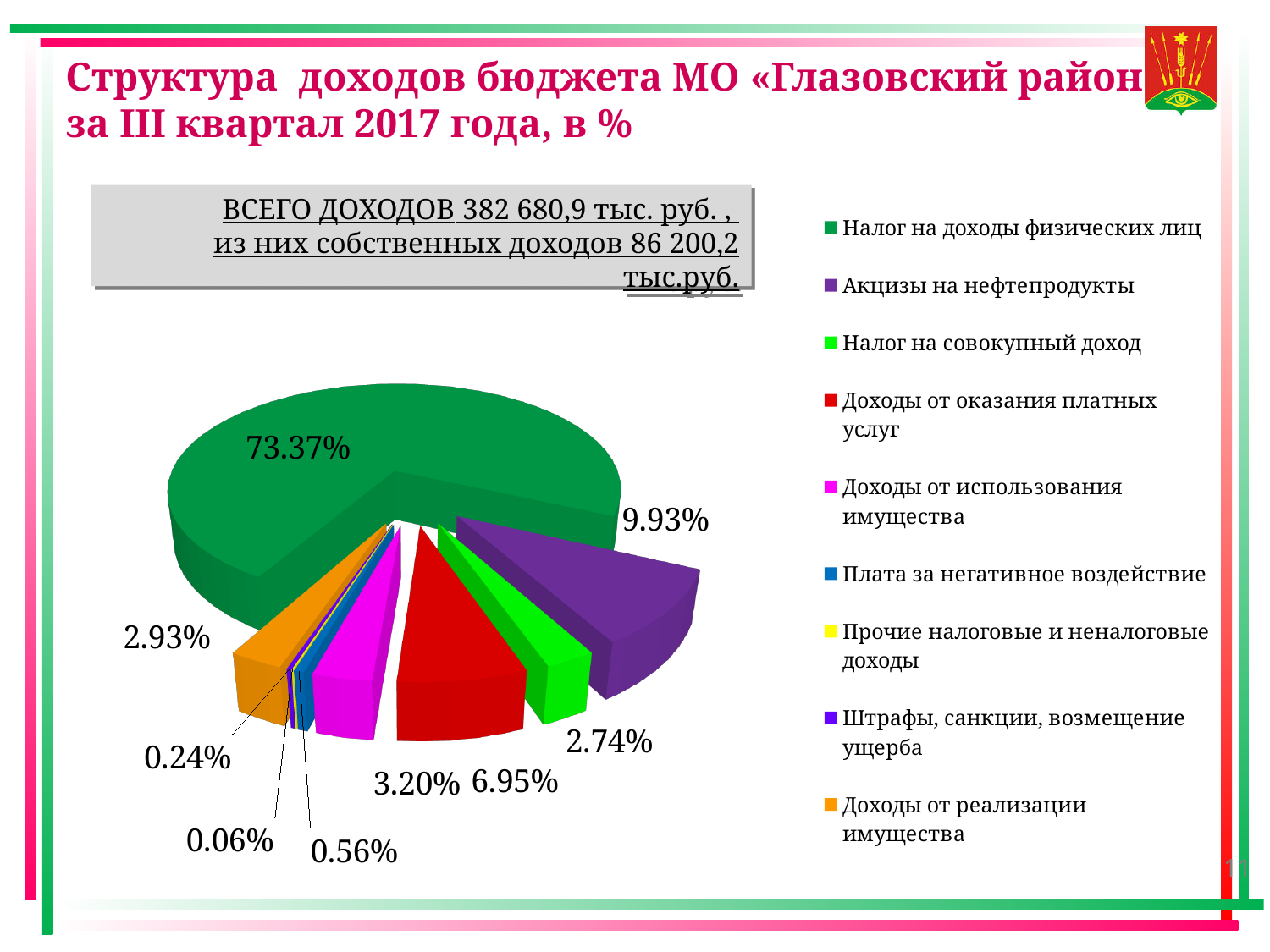
How many categories does the legend list? 9 What is the value shown for «Доходы от использования имущества»? 3.20% What is the value shown for «Доходы от реализации имущества»? 2.93% What type of chart is shown on the slide? Pie chart Which category has the largest share of the pie? Налог на доходы физических лиц What colour is the slice for «Штрафы, санкции, возмещение ущерба»? Violet (purple) What is the difference between the shares of «Акцизы на нефтепродукты» and «Доходы от оказания платных услуг»? 2.98% What share of the pie does «Налог на доходы физических лиц» have? 73.37% What is the value shown for «Акцизы на нефтепродукты»? 9.93% Which is larger: «Налог на совокупный доход» or «Доходы от оказания платных услуг»? Доходы от оказания платных услуг What is the value shown for «Доходы от оказания платных услуг»? 6.95% Which category has the smallest share of the pie? Прочие налоговые и неналоговые доходы